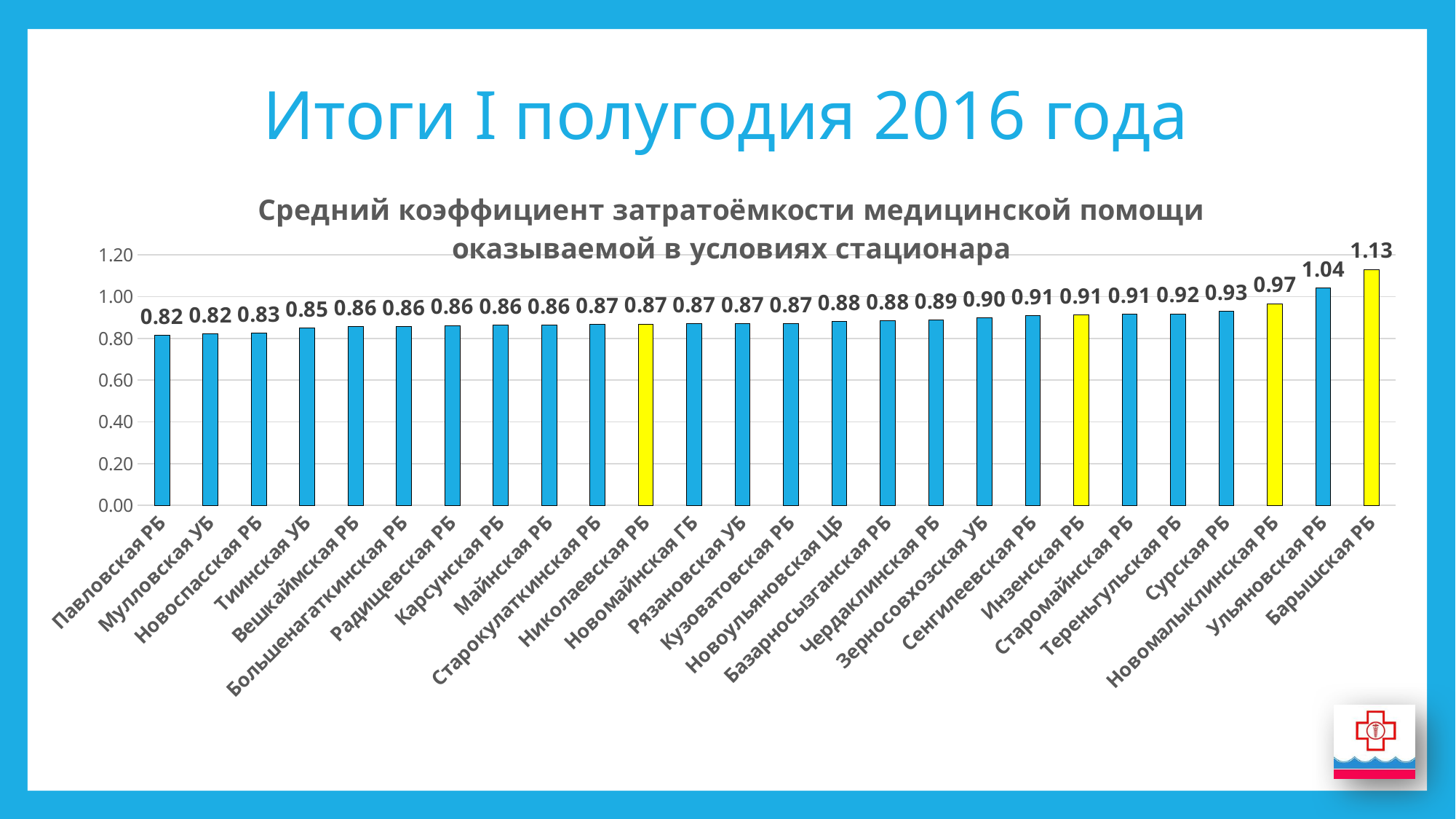
Is the value for Павловская РБ greater or less than 1.00? less Which category has the highest value? Барышская РБ Do the values generally rise or fall from left to right along the x axis? rise What is the value for Новомалыклинская РБ? 0.97 Which is larger, the value for Сурская РБ or the value for Тиинская УБ? Сурская РБ What type of chart is shown on the slide? bar chart What is the value for Барышская РБ? 1.13 How many categories are shown in the chart? 26 What is the value for Ульяновская РБ? 1.04 What is the difference between the values for Барышская РБ and Ульяновская РБ? 0.09 What is the lowest value shown in the chart? 0.82 What is the value for Чердаклинская РБ? 0.89